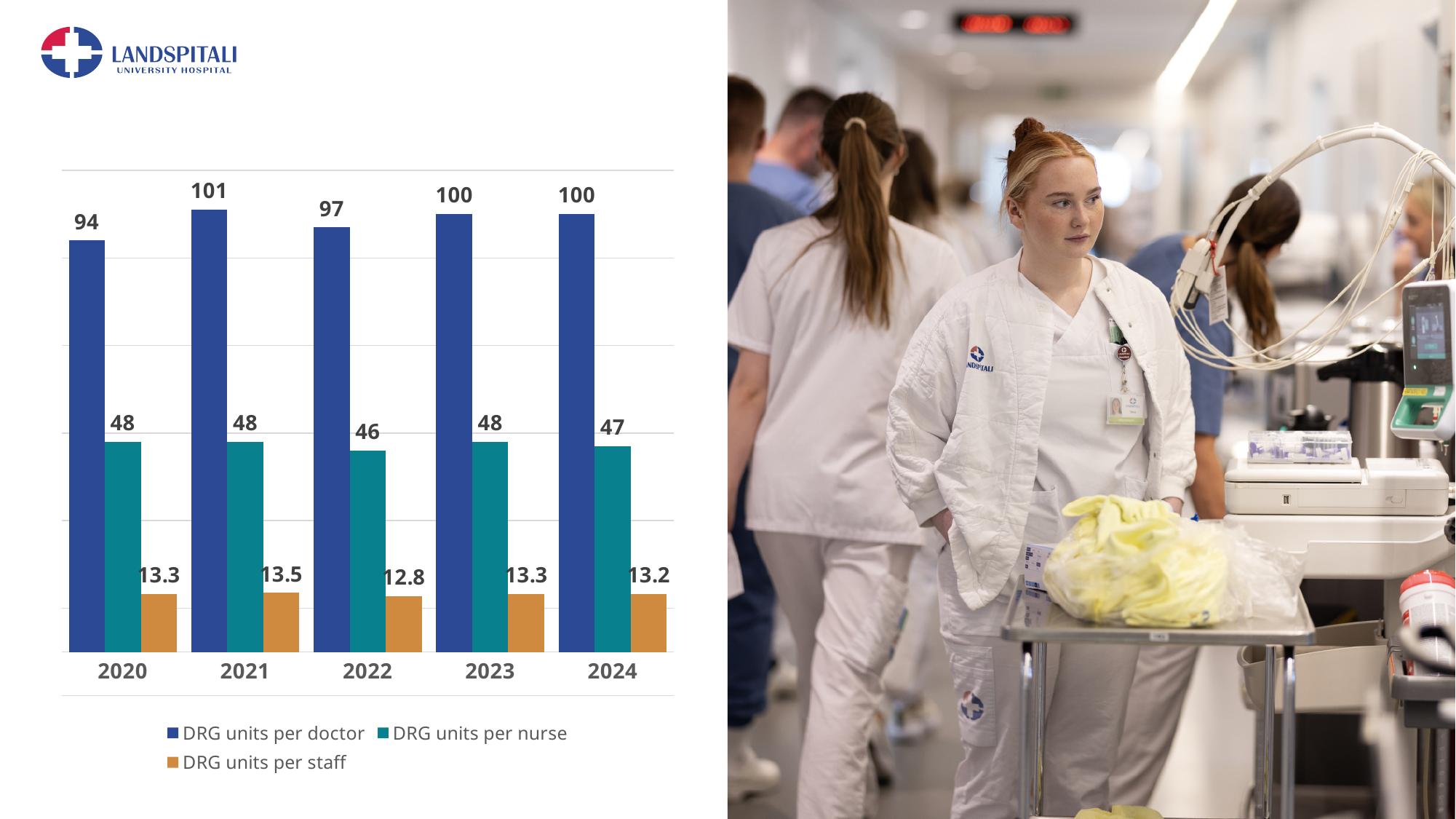
What is the difference between DRG units per staff in 2021 and in 2022? 0.7 How many series does the legend list? 3 What is the value of DRG units per staff in 2024? 13.2 What is the value of DRG units per doctor in 2021? 101 Which is larger: DRG units per nurse in 2023 or in 2024? 2023 What kind of chart is shown on the slide? Bar chart What is the difference between DRG units per doctor in 2021 and in 2020? 7 In which year is DRG units per doctor highest? 2021 Which series is shown in orange in the legend? DRG units per staff How many years are shown on the x axis? 5 What is the value of DRG units per nurse in 2022? 46 In which year is DRG units per staff lowest? 2022